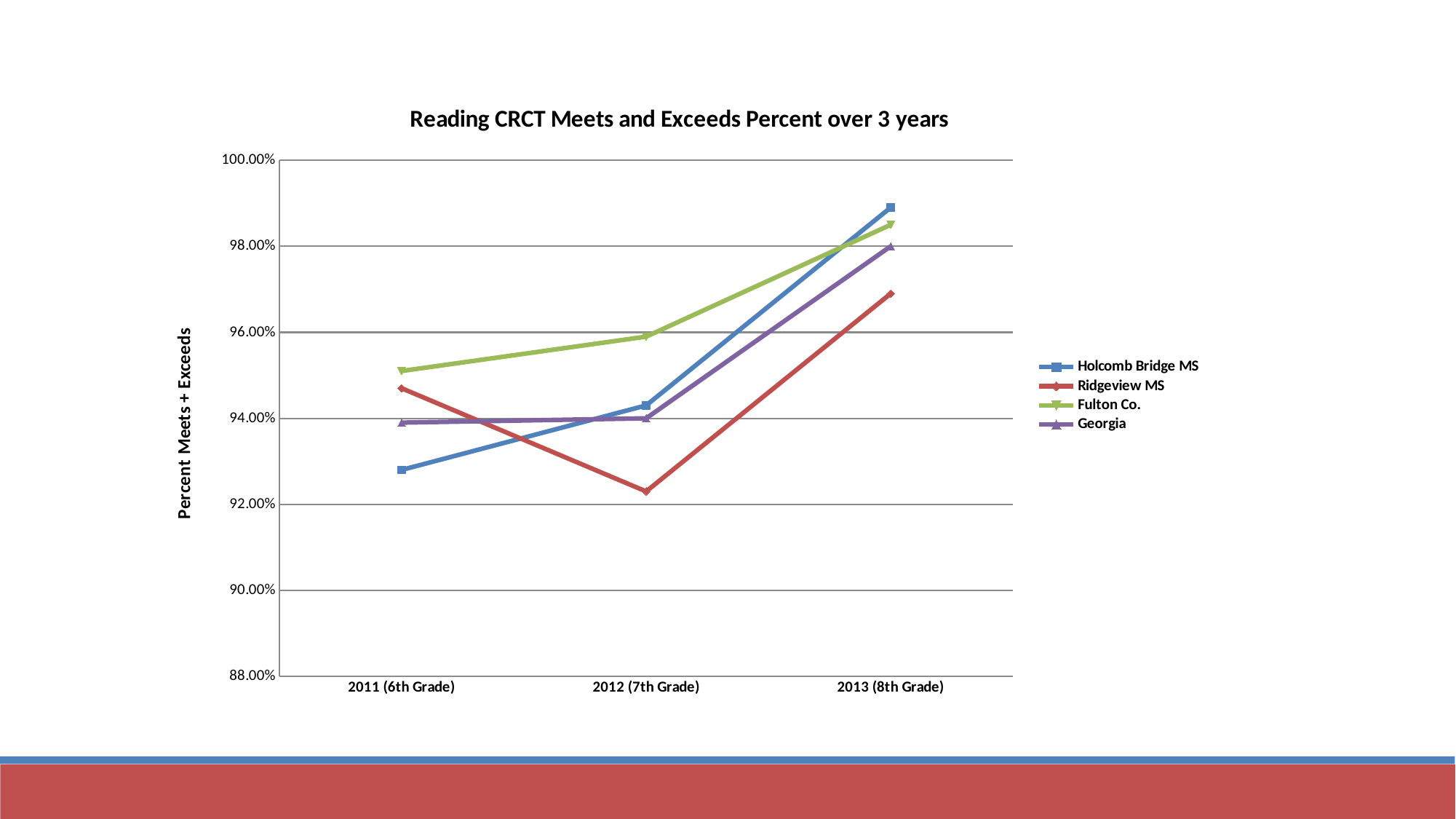
In 2011 (6th Grade), which is larger: Ridgeview MS or Holcomb Bridge MS? Ridgeview MS Is the value for Holcomb Bridge MS in 2011 (6th Grade) greater or less than 94.00%? less Is the value for Holcomb Bridge MS in 2013 (8th Grade) greater or less than 98.00%? greater Which series has the lowest value in 2011 (6th Grade)? Holcomb Bridge MS Is the value for Ridgeview MS in 2013 (8th Grade) greater or less than 98.00%? less Which series has the lowest value in 2012 (7th Grade)? Ridgeview MS How many series does the legend list? 4 What kind of chart is shown on the slide? Line chart Which series has the highest value in 2011 (6th Grade)? Fulton Co. Which series has the highest value in 2013 (8th Grade)? Holcomb Bridge MS How many points are on the x axis? 3 Does the Holcomb Bridge MS line rise or fall from 2011 (6th Grade) to 2013 (8th Grade)? Rise